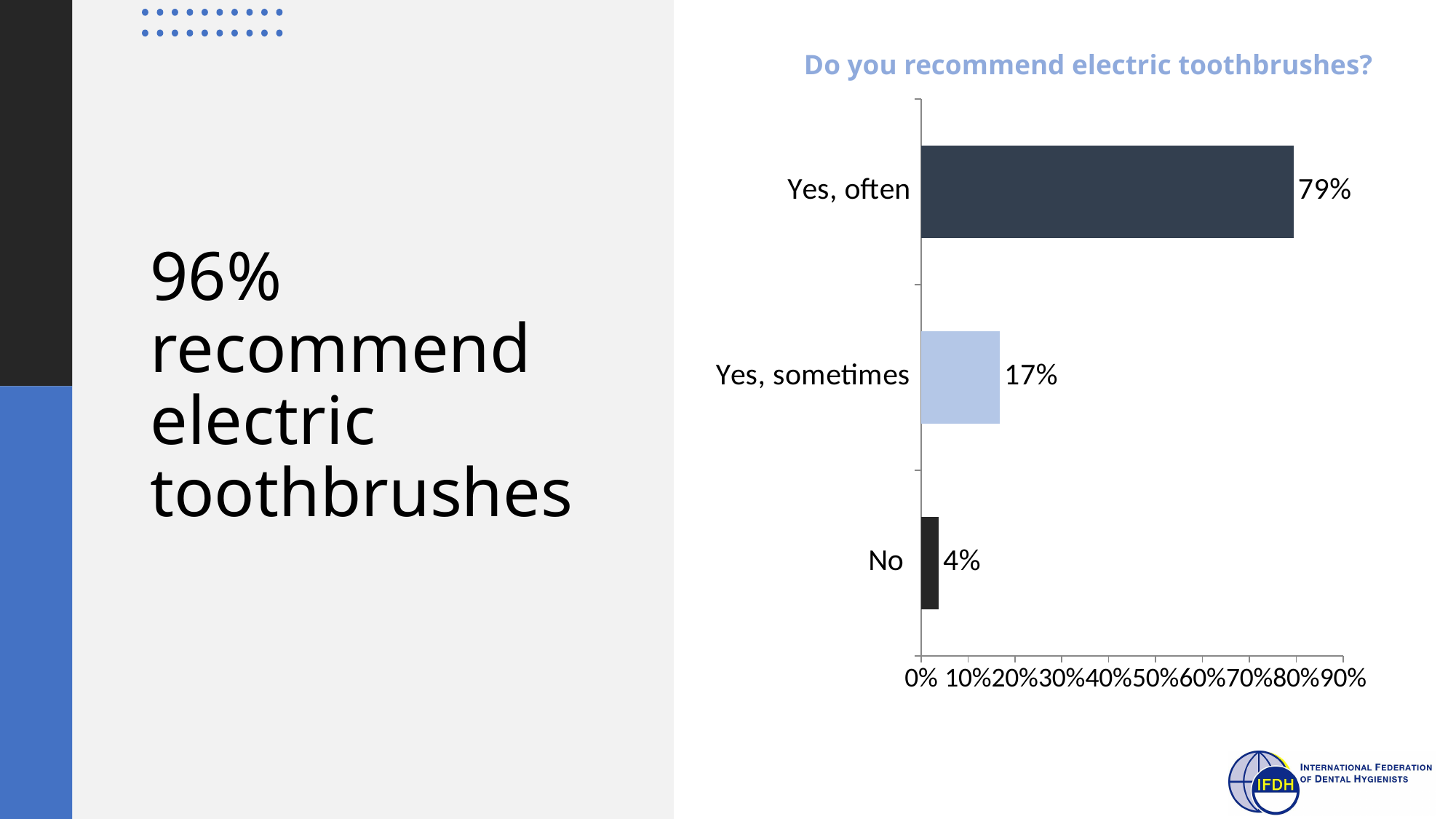
What is the difference between the "Yes, often" and "Yes, sometimes" values? 62% What kind of chart is shown on the slide? Bar chart Which response category has the lowest value? No What percentage of respondents answered "Yes, often" to recommending electric toothbrushes? 79% What is the title of the chart? Do you recommend electric toothbrushes? What is the difference between the "Yes, sometimes" and "No" values? 13% How many response categories are shown in the chart? 3 What percentage of respondents answered "No"? 4% Which response category has the highest value? Yes, often What percentage of respondents answered "Yes, sometimes"? 17% Which is larger, the value for "Yes, sometimes" or the value for "No"? Yes, sometimes Is the value for "Yes, often" greater or less than 70%? greater